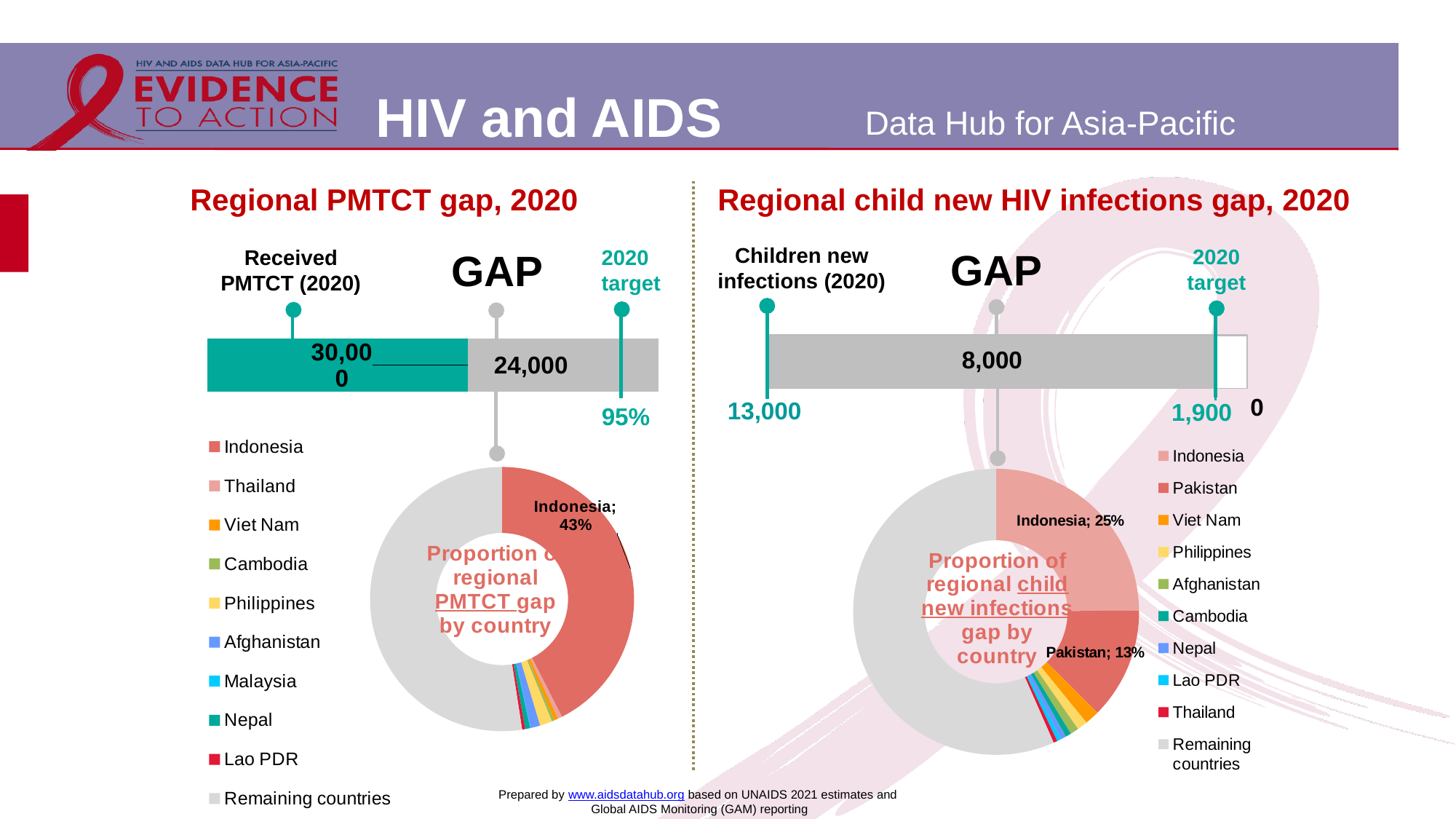
On the Regional PMTCT gap, 2020 chart, what is the 2020 target? 95% In the Proportion of regional child new infections gap by country donut chart, what share does Pakistan have? 13% In the Proportion of regional PMTCT gap by country donut chart, what share does Indonesia have? 43% In the Proportion of regional child new infections gap by country donut chart, what share does Indonesia have? 25% On the Regional child new HIV infections gap, 2020 chart, how many children new infections were there in 2020? 13,000 On the Regional child new HIV infections gap, 2020 chart, what is the size of the GAP? 8,000 On the Regional PMTCT gap, 2020 chart, what is the size of the GAP? 24,000 On the Regional child new HIV infections gap, 2020 chart, what is the 2020 target? 1,900 On the Regional PMTCT gap, 2020 chart, how many received PMTCT in 2020? 30,000 How many entries does the legend of the Proportion of regional PMTCT gap by country donut chart list? 10 On the Regional PMTCT gap, 2020 chart, what is the combined total of those who received PMTCT and the gap? 54,000 In the Proportion of regional child new infections gap by country donut chart, how many percentage points larger is Indonesia's share than Pakistan's? 12 percentage points